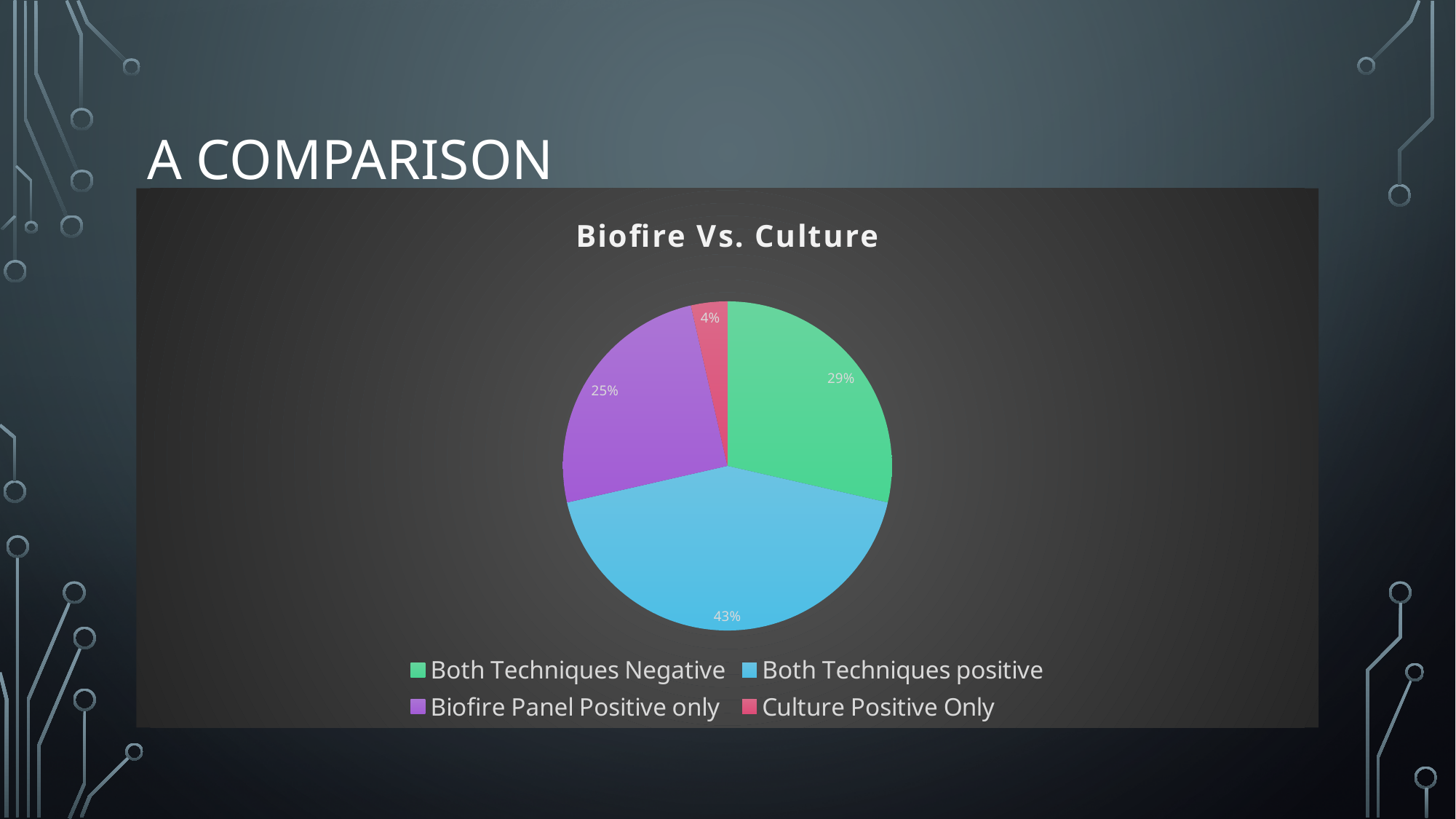
Which category has the smallest slice of the pie? Culture Positive Only What type of chart is shown on the slide? Pie chart What colour is the Both Techniques positive slice? Blue Which category has the largest slice of the pie? Both Techniques positive How many categories does the pie chart have? 4 What is the difference in percentage points between Both Techniques positive and Both Techniques Negative? 14 What is the title of the chart? Biofire Vs. Culture What percentage of the pie is Culture Positive Only? 4% What percentage of the pie is Both Techniques Negative? 29% Which is larger, the Biofire Panel Positive only slice or the Culture Positive Only slice? Biofire Panel Positive only What percentage of the pie is Biofire Panel Positive only? 25% What percentage of the pie is Both Techniques positive? 43%